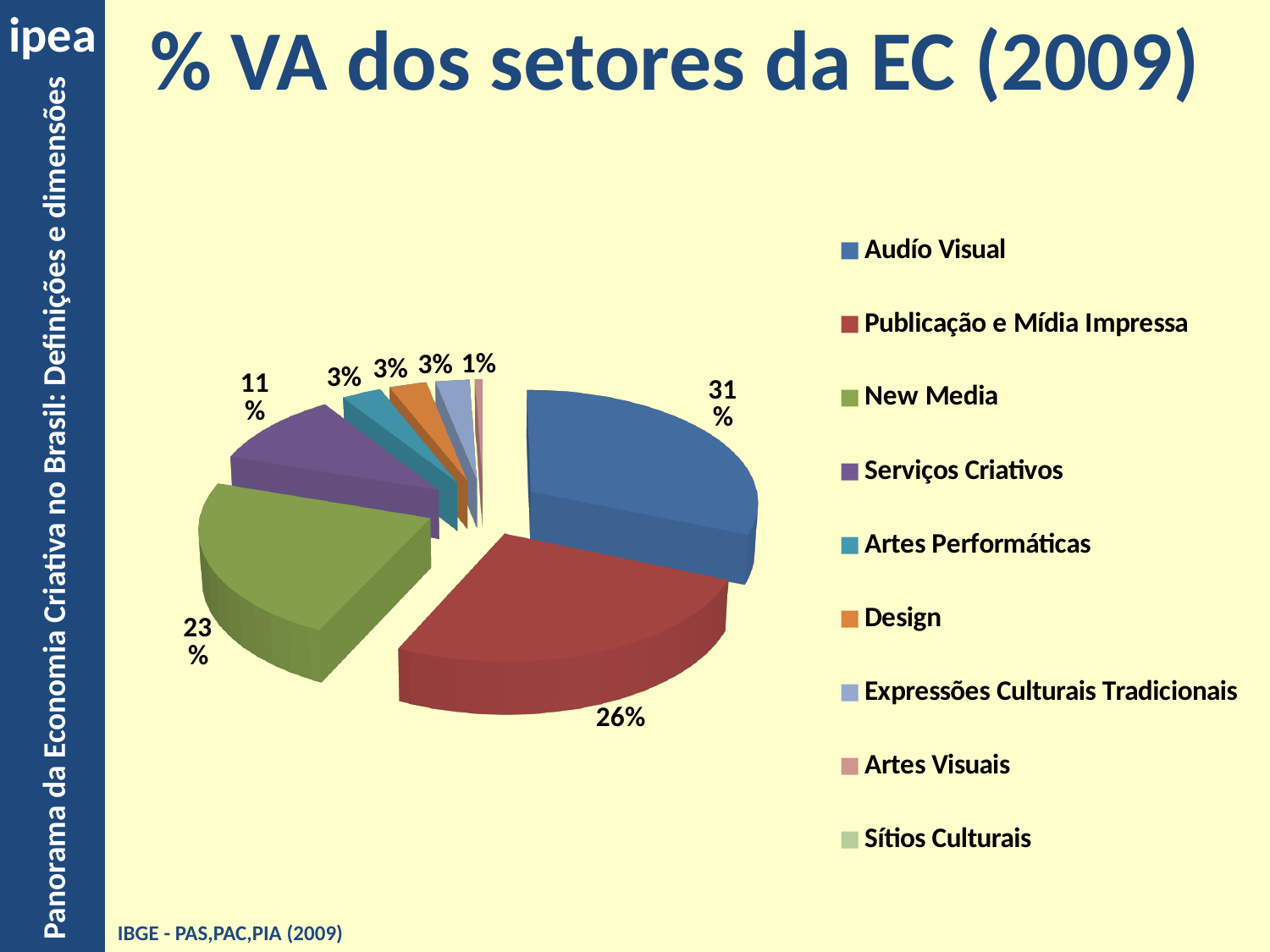
What percentage of the pie does Audío Visual account for? 31% What kind of chart is shown on the slide? pie chart What is the value shown for Artes Visuais? 1% What is the value shown for Publicação e Mídia Impressa? 26% How many sectors are listed in the legend? 9 Which is larger, the slice for New Media or the slice for Serviços Criativos? New Media What share of the pie is New Media? 23% Which sector has the largest slice of the pie? Audío Visual What is the title of the chart? % VA dos setores da EC (2009) What is the difference in percentage points between Audío Visual and Publicação e Mídia Impressa? 5 percentage points What is the difference in percentage points between New Media and Serviços Criativos? 12 percentage points What is the value shown for Serviços Criativos? 11%